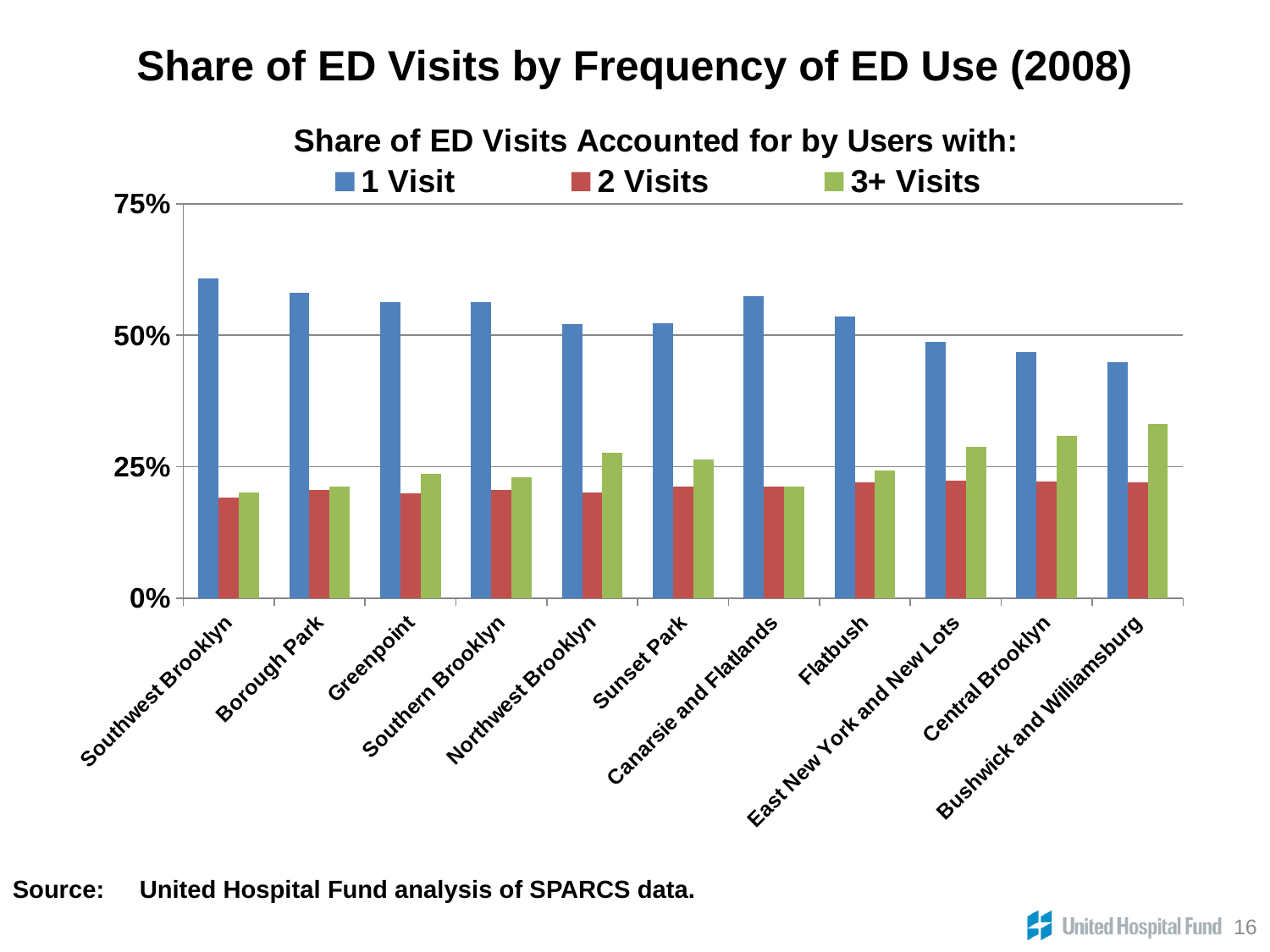
Which neighborhood has the highest share of ED visits from users with 3+ Visits? Bushwick and Williamsburg What kind of chart is shown on the slide? Bar chart Which neighborhood has the lowest share of ED visits from users with 1 Visit? Bushwick and Williamsburg How many series does the legend list? 3 Which neighborhood has the highest share of ED visits from users with 1 Visit? Southwest Brooklyn Is the 1 Visit value for Southwest Brooklyn greater or less than 50%? greater Do the 1 Visit values generally rise or fall moving from left to right across the neighborhoods? Fall Is the 2 Visits value for Flatbush greater or less than 25%? less Which is larger: the 3+ Visits value for Northwest Brooklyn or for Greenpoint? Northwest Brooklyn Is the 3+ Visits value for Bushwick and Williamsburg greater or less than 25%? greater How many neighborhoods are shown on the x axis? 11